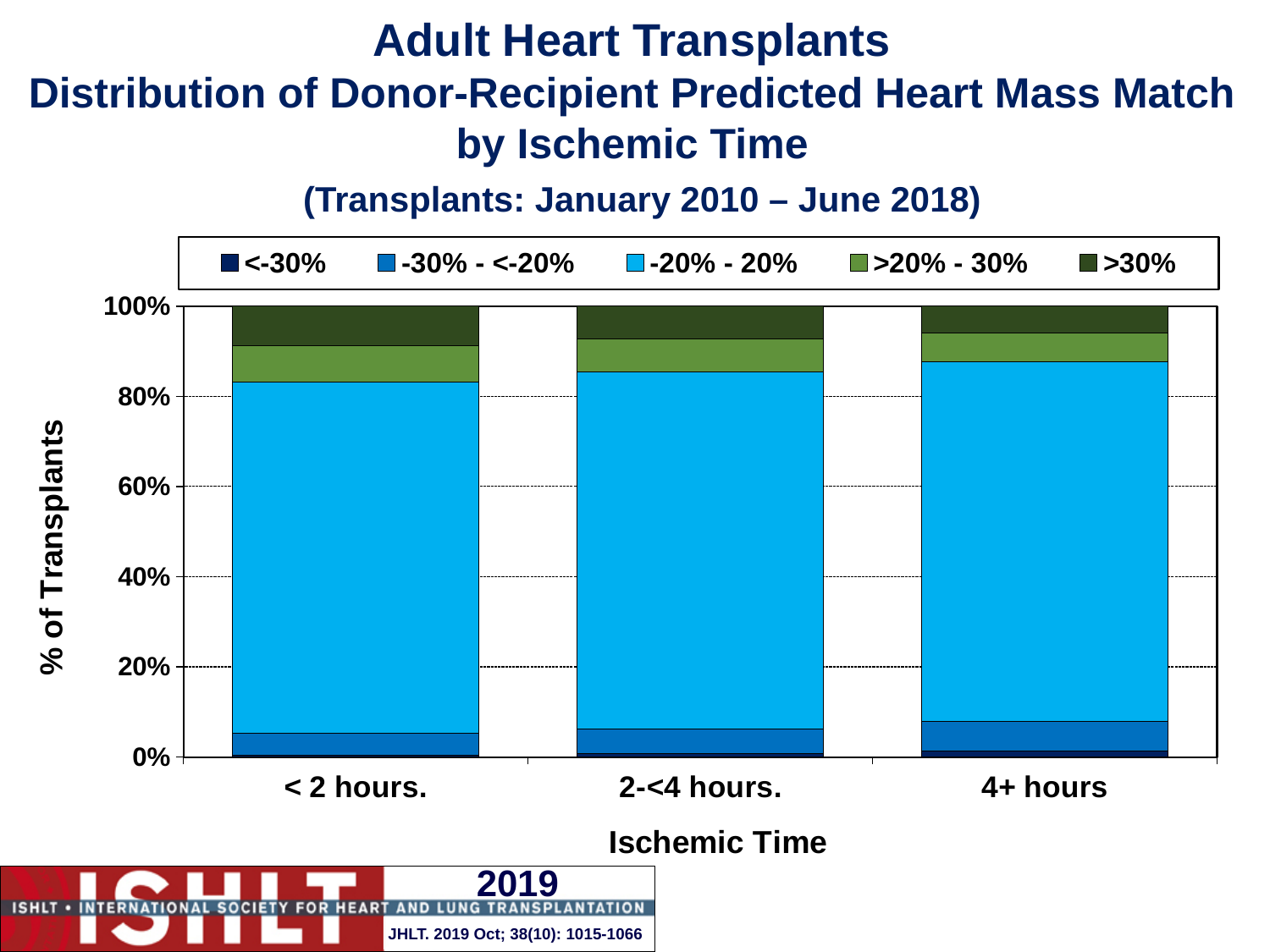
Is the top of the -20% - 20% segment for 4+ hours greater or less than 80%? greater Is the -30% - <-20% segment for 2-<4 hours greater or less than 20%? less Which series makes up the largest share of each bar? -20% - 20% Is the top of the -20% - 20% segment for < 2 hours greater or less than 80%? greater Which ischemic time category has the larger -30% - <-20% segment, < 2 hours or 4+ hours? 4+ hours How many series does the legend list? 5 Which ischemic time category has the larger >30% segment, < 2 hours or 4+ hours? < 2 hours What is the label of the x axis? Ischemic Time What is the total height of the stacked bar for 2-<4 hours? 100% What kind of chart is shown on the slide? Stacked bar chart What is the label of the y axis? % of Transplants How many ischemic time categories are shown on the x axis? 3